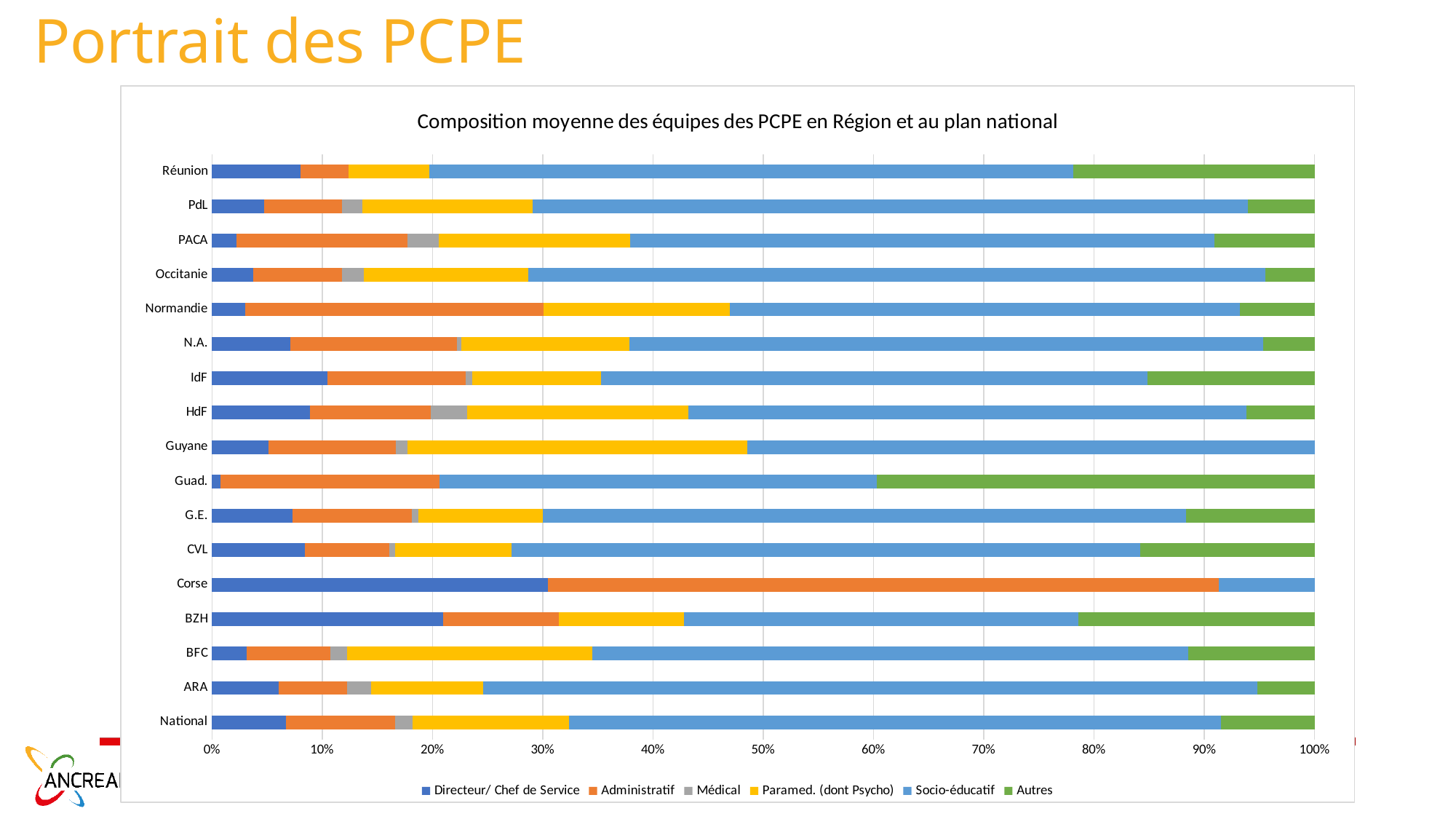
Which category has the largest Directeur/ Chef de Service share? Corse Which category has the largest Autres share? Guad. Is the Autres share for Guad. greater or less than 30%? greater Is the Administratif share for Normandie greater or less than 20%? greater How many series does the legend list? 6 What does each full stacked bar add up to on the horizontal axis? 100% Which category has the largest Administratif share? Corse What is the title of the chart? Composition moyenne des équipes des PCPE en Région et au plan national How many regions/categories are plotted on the vertical axis? 17 What kind of chart is shown on the slide? Stacked bar chart Is the Directeur/ Chef de Service share for Corse greater or less than 20%? greater Is the Socio-éducatif share larger for Guyane or for Corse? Guyane